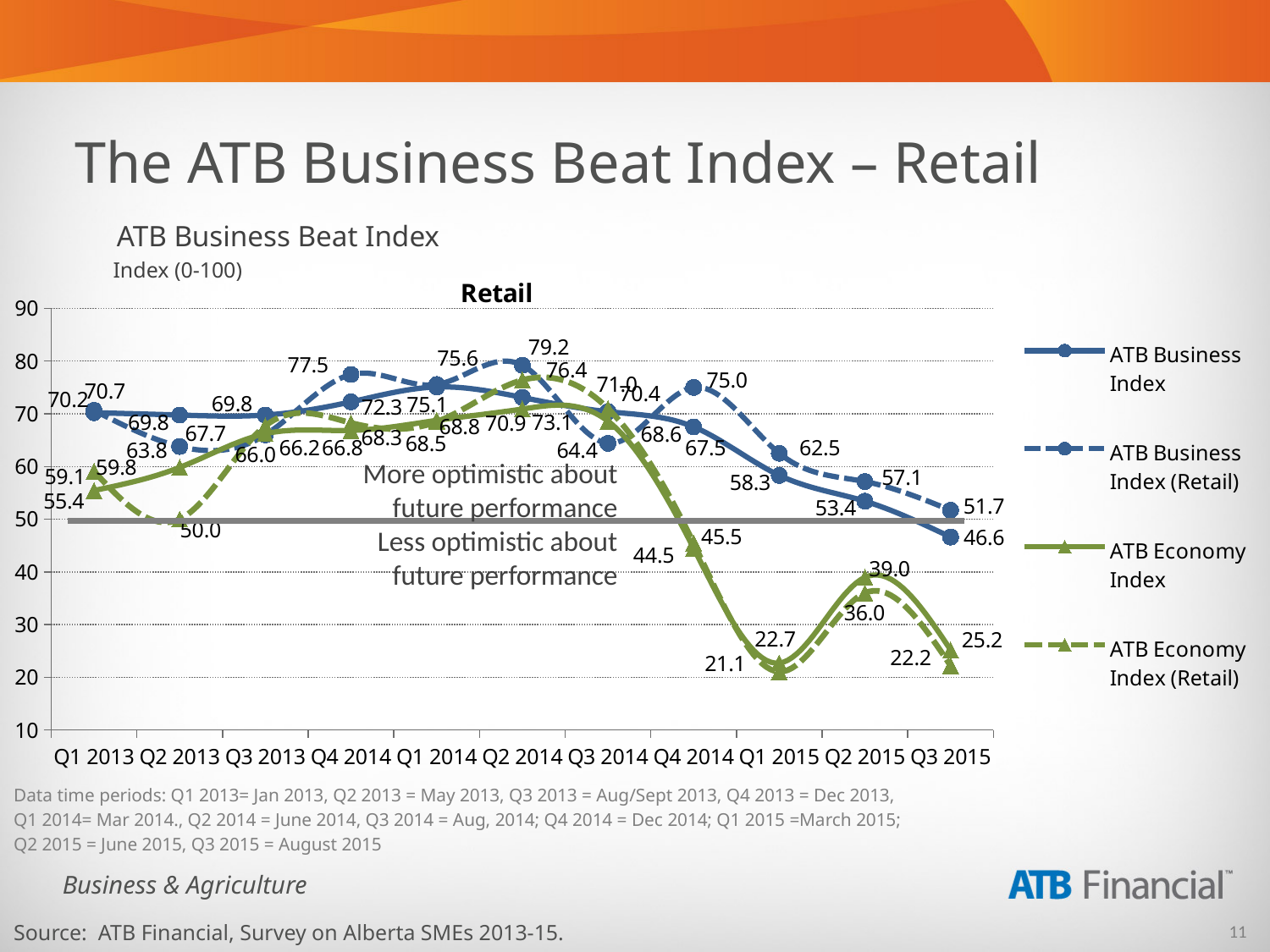
What is the value of the ATB Business Index (Retail) in Q2 2015? 57.1 In which quarter does the ATB Business Index (Retail) reach its highest value? Q2 2014 What kind of chart is shown on the slide? line chart What is the highest value reached by the ATB Business Index (Retail)? 79.2 What is the value of the ATB Business Index in Q3 2015? 46.6 In Q3 2015, which is larger: the ATB Business Index or the ATB Business Index (Retail)? ATB Business Index (Retail) How many quarters are plotted along the x axis? 11 Is the value of the ATB Business Index in Q3 2015 greater or less than 50? less What is the value of the ATB Business Index (Retail) in Q3 2015? 51.7 What is the difference between the ATB Business Index (Retail) and the ATB Business Index in Q3 2015? 5.1 How many series does the legend list? 4 In which quarter is the ATB Economy Index at its lowest? Q1 2015